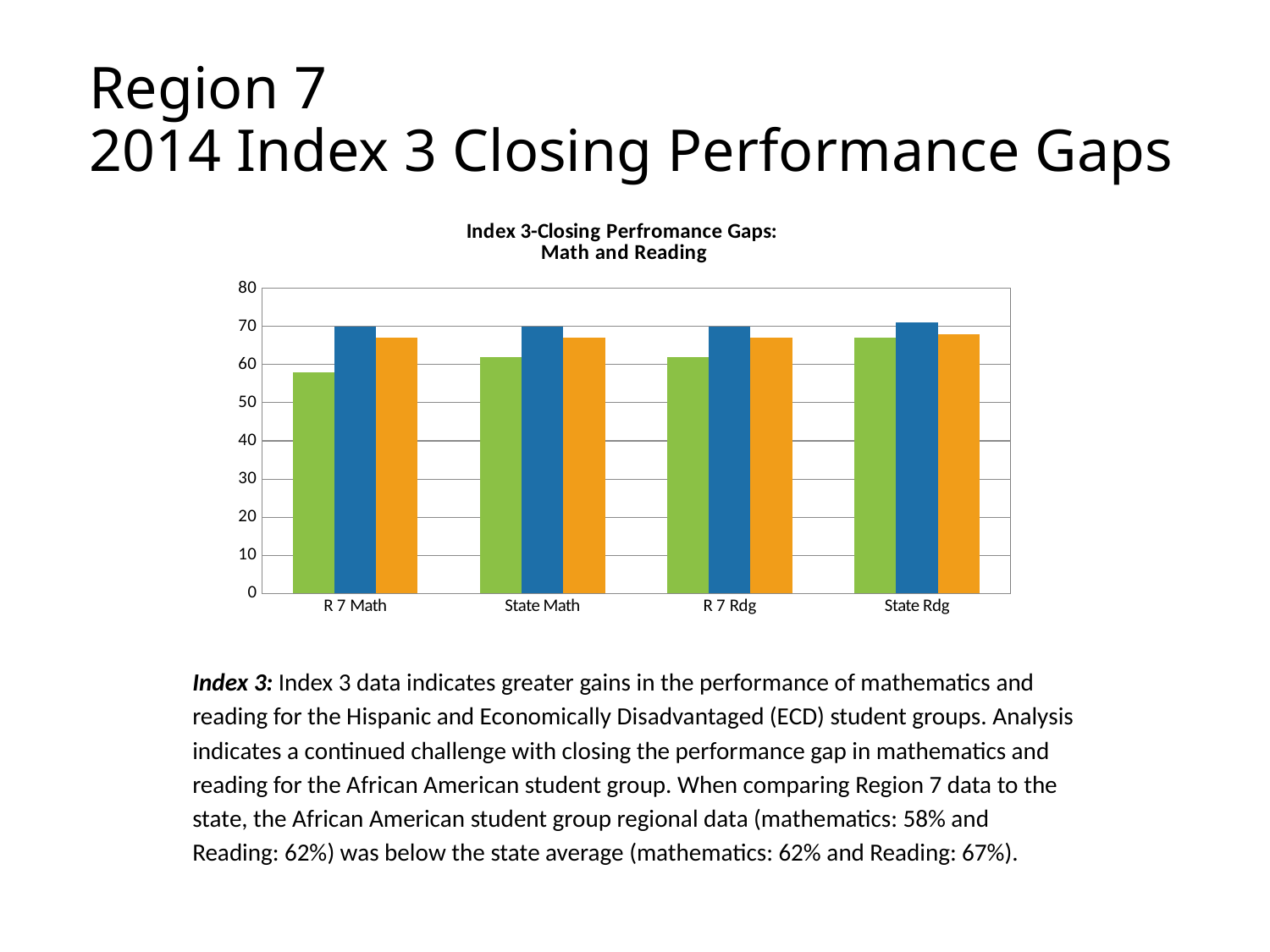
Is the value of the green bar for R 7 Math greater or less than 60? less What kind of chart is shown on the slide? bar chart How many categories are shown on the x axis of the chart? 4 What is the title of the chart? Index 3-Closing Perfromance Gaps: Math and Reading Is the value of the green bar for State Rdg greater or less than 60? greater How many bars are plotted for each category in the chart? 3 Which is larger for R 7 Math: the green bar or the blue bar? the blue bar Is the value of the orange bar for R 7 Rdg greater or less than 70? less What is the maximum value shown on the y axis of the chart? 80 Which category has the lowest green bar? R 7 Math Which is larger: the green bar for R 7 Math or the green bar for State Rdg? State Rdg